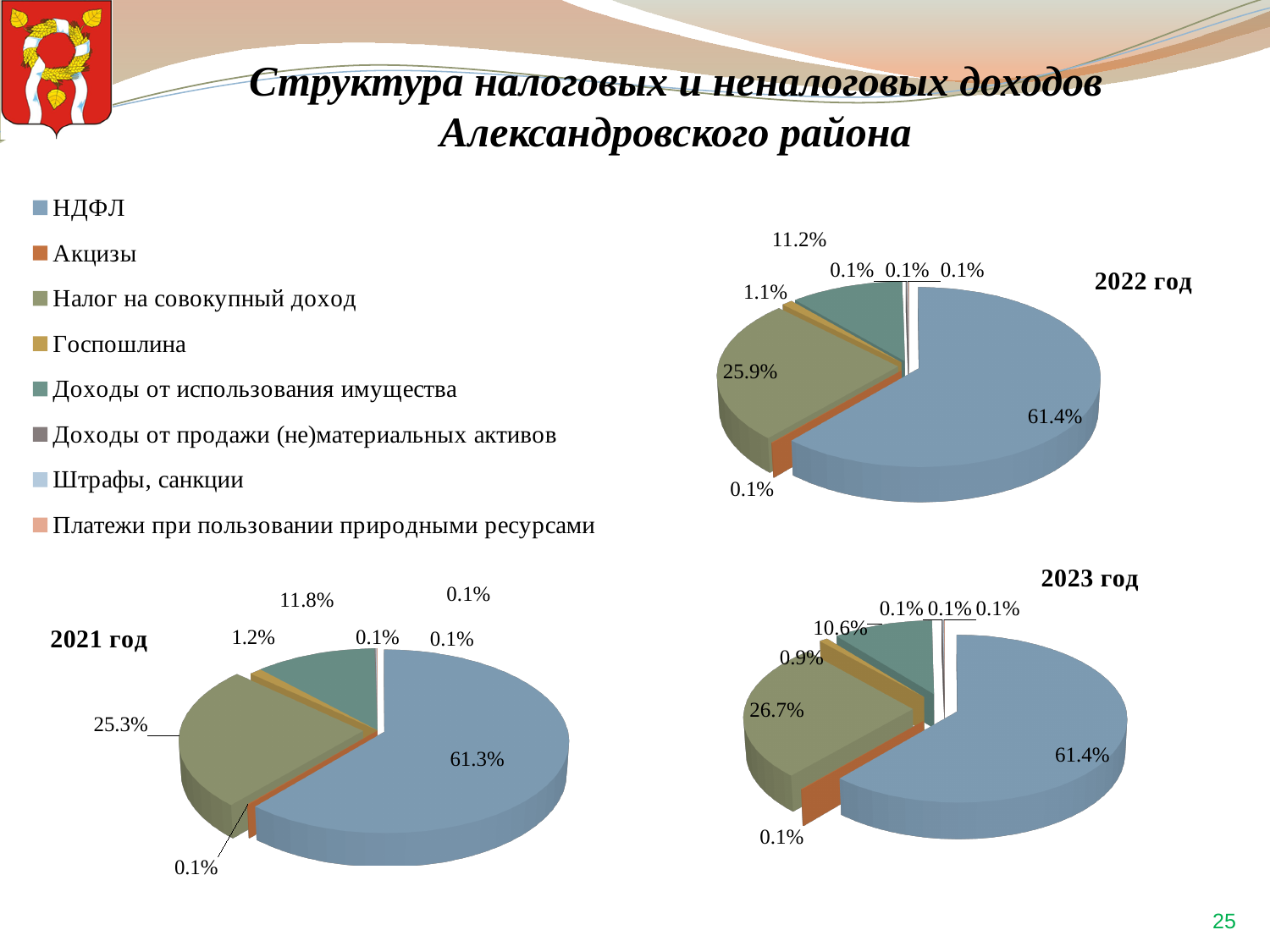
In the 2022 год pie chart, what share does Госпошлина have? 1.1% In the 2021 год pie chart, what is the difference between the shares of Налог на совокупный доход and Доходы от использования имущества? 13.5% How many entries does the legend list? 8 In the 2022 год pie chart, which category has the largest share? НДФЛ In the 2023 год pie chart, what share does Госпошлина have? 0.9% Which legend entry is shown in blue? НДФЛ What kind of charts are shown on the slide? Pie charts In the 2021 год pie chart, what share does НДФЛ have? 61.3% Which is larger: the share of Налог на совокупный доход in 2023 год or in 2022 год? 2023 год In the 2022 год pie chart, what share does Налог на совокупный доход have? 25.9% In the 2023 год pie chart, what share does Доходы от использования имущества have? 10.6% How many pie charts are on the slide? 3